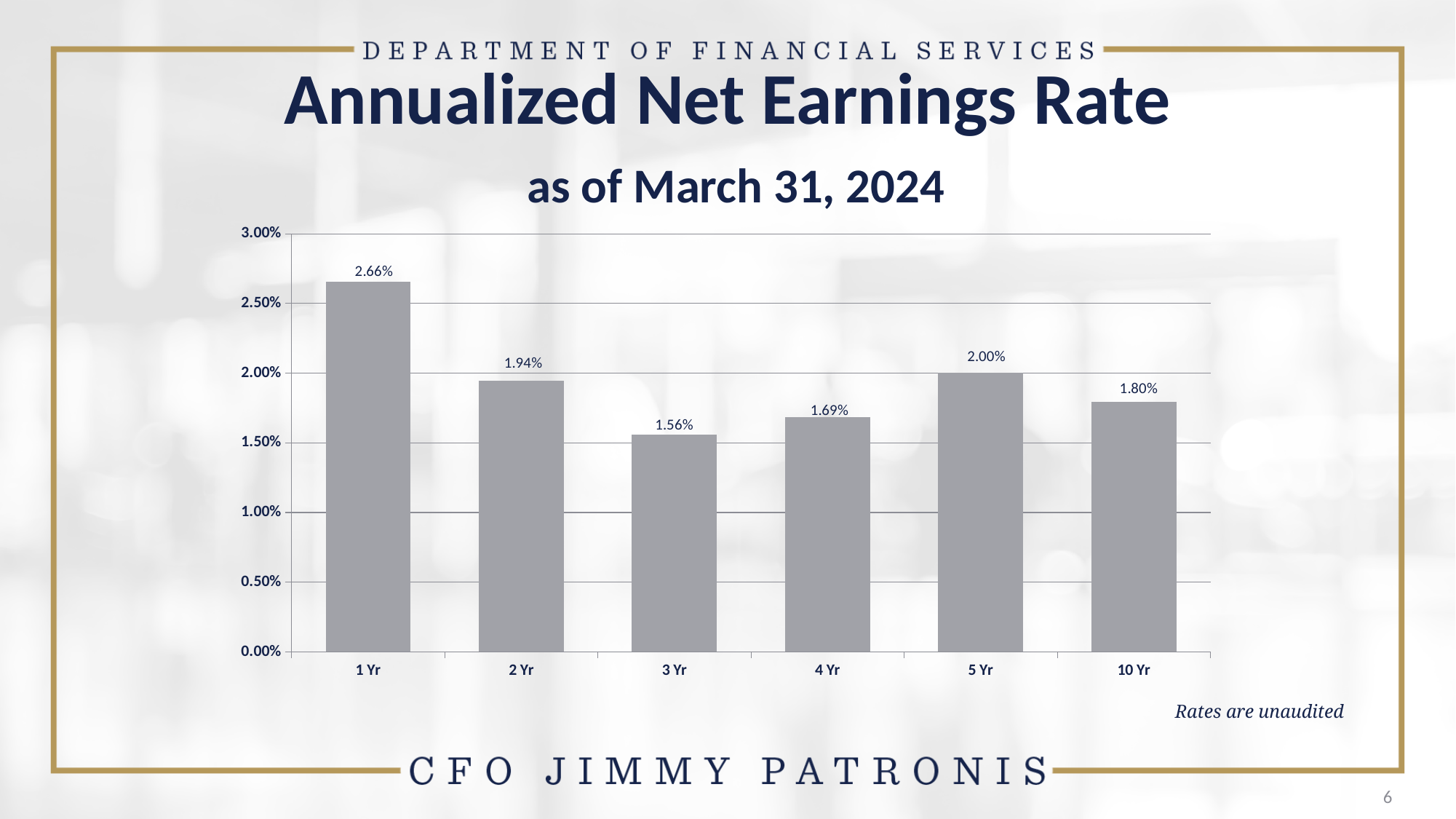
Which period has the highest annualized net earnings rate? 1 Yr What is the annualized net earnings rate for 10 Yr? 1.80% How many periods are shown on the chart? 6 What kind of chart is shown on the slide? Bar chart Is the value for 4 Yr greater or less than 2.00%? less As of what date are the annualized net earnings rates reported? March 31, 2024 Which is larger, the 5 Yr rate or the 10 Yr rate? 5 Yr What is the difference between the 5 Yr rate and the 4 Yr rate? 0.31% Which period has the lowest annualized net earnings rate? 3 Yr What is the annualized net earnings rate for 1 Yr? 2.66% What is the annualized net earnings rate for 3 Yr? 1.56% What is the difference between the 1 Yr rate and the 2 Yr rate? 0.72%